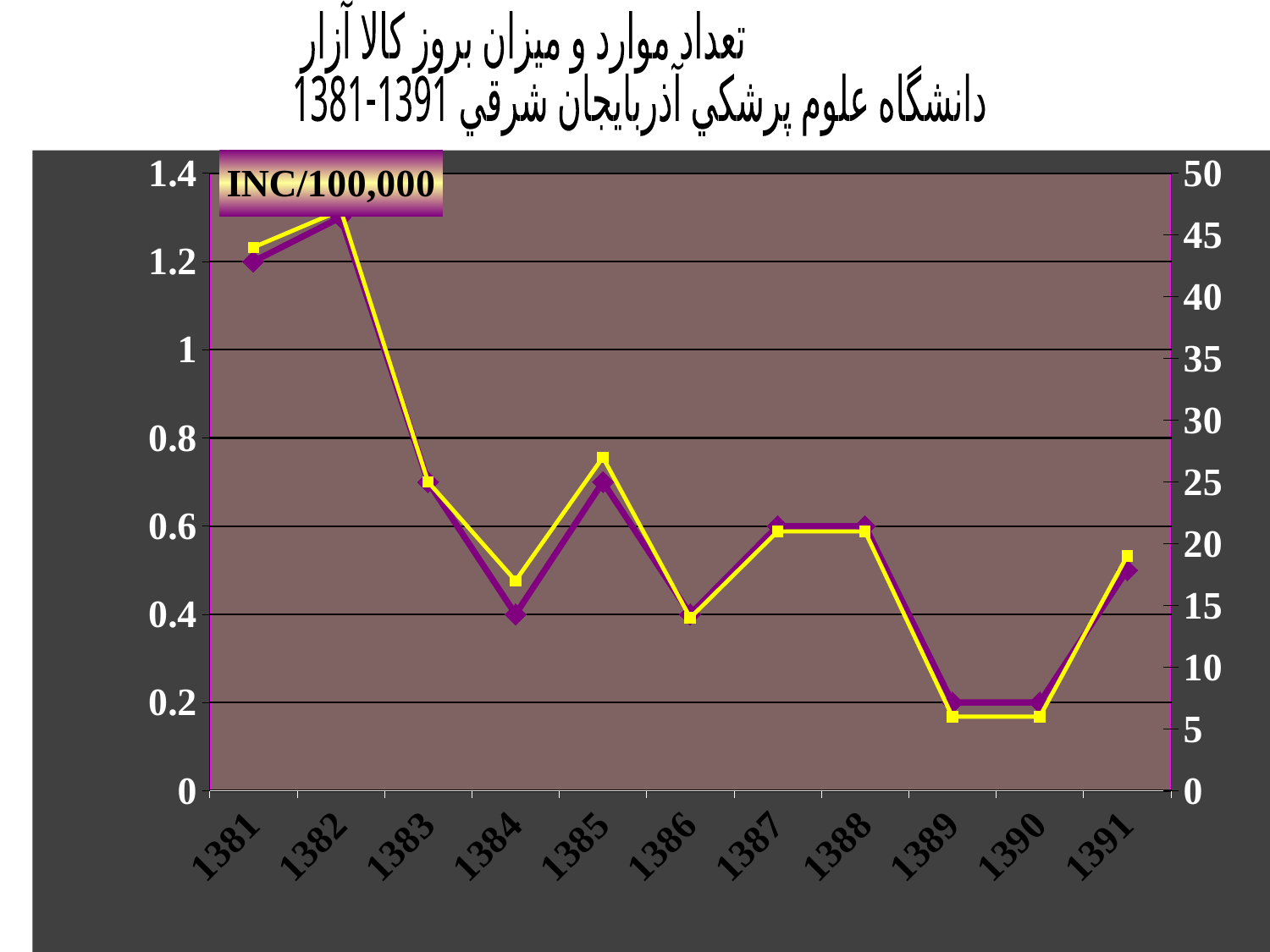
What is the maximum value shown on the right-hand axis of the chart? 50 How many years are plotted along the x axis of the chart? 11 What kind of chart is shown on the slide? line chart What is the first year shown on the x axis of the chart? 1381 Do the lines generally rise or fall from 1381 to 1390? fall Between 1390 and 1391, do the lines rise or fall? rise What is the last year shown on the x axis of the chart? 1391 Which is higher on the yellow line, the point for 1385 or the point for 1386? 1385 In which year does the yellow line reach its highest point? 1382 In which year does the purple line reach its highest point? 1382 Which is higher on the purple line, the point for 1383 or the point for 1384? 1383 Which is higher on the purple line, the point for 1382 or the point for 1391? 1382